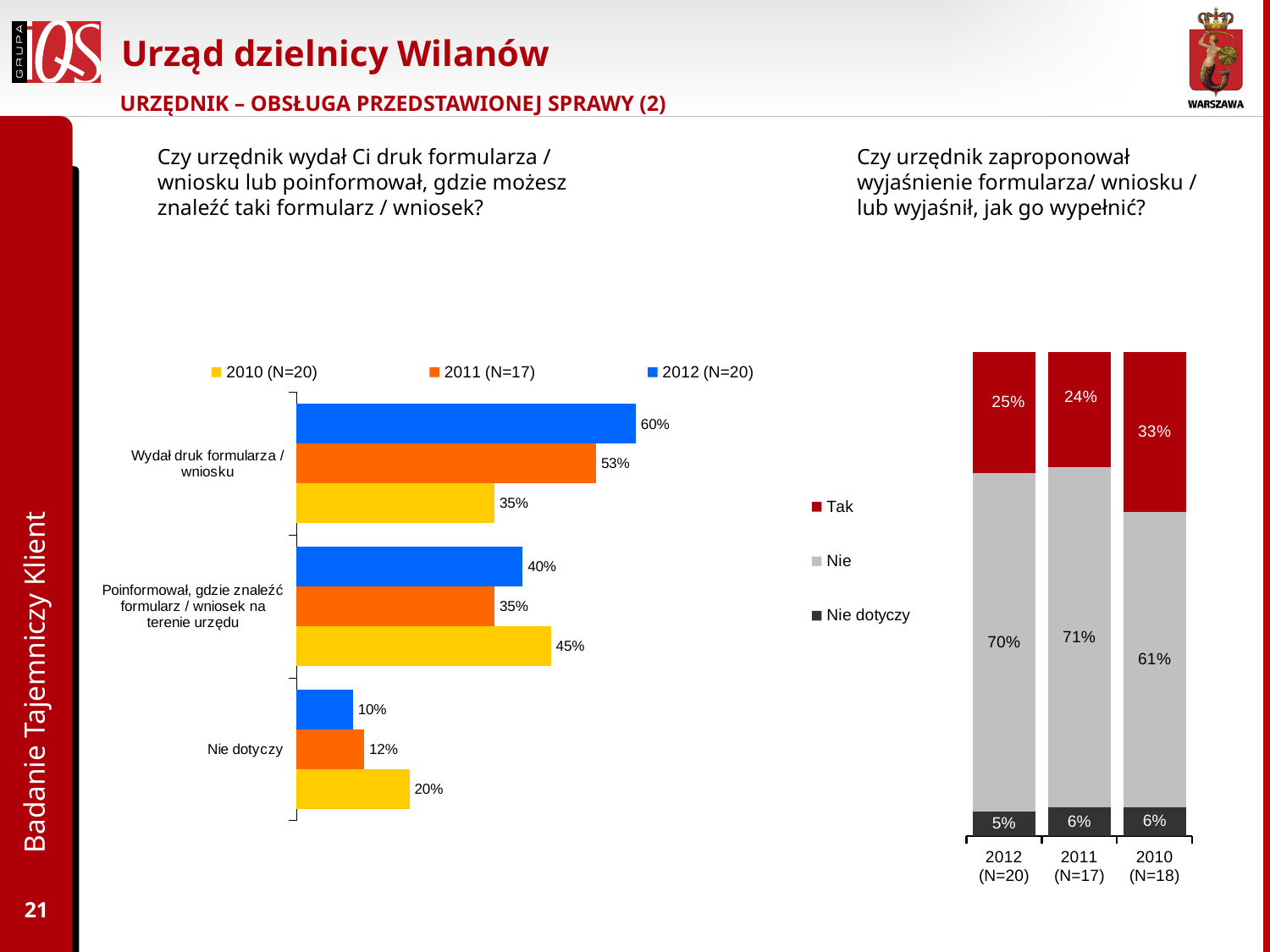
In the right chart, what is the total of the 2012 (N=20) stacked bar? 100% What kind of chart is the chart on the left? Bar chart In the left chart, what is the value for 2011 (N=17) for 'Nie dotyczy'? 12% In the left chart, what is the value for 2010 (N=20) for 'Poinformował, gdzie znaleźć formularz / wniosek na terenie urzędu'? 45% In the left chart, how many categories are shown? 3 In the right chart, which year has the highest 'Tak' share? 2010 (N=18) In the left chart, what is the difference between the 2012 and 2010 values for 'Wydał druk formularza / wniosku'? 25% In the left chart, what is the value for 2012 (N=20) for 'Wydał druk formularza / wniosku'? 60% In the right chart, what is the 'Nie' share for 2011 (N=17)? 71% In the left chart, which series has the highest value for 'Wydał druk formularza / wniosku'? 2012 (N=20) In the left chart, how many series does the legend list? 3 In the right chart, what is the 'Tak' share for 2010 (N=18)? 33%